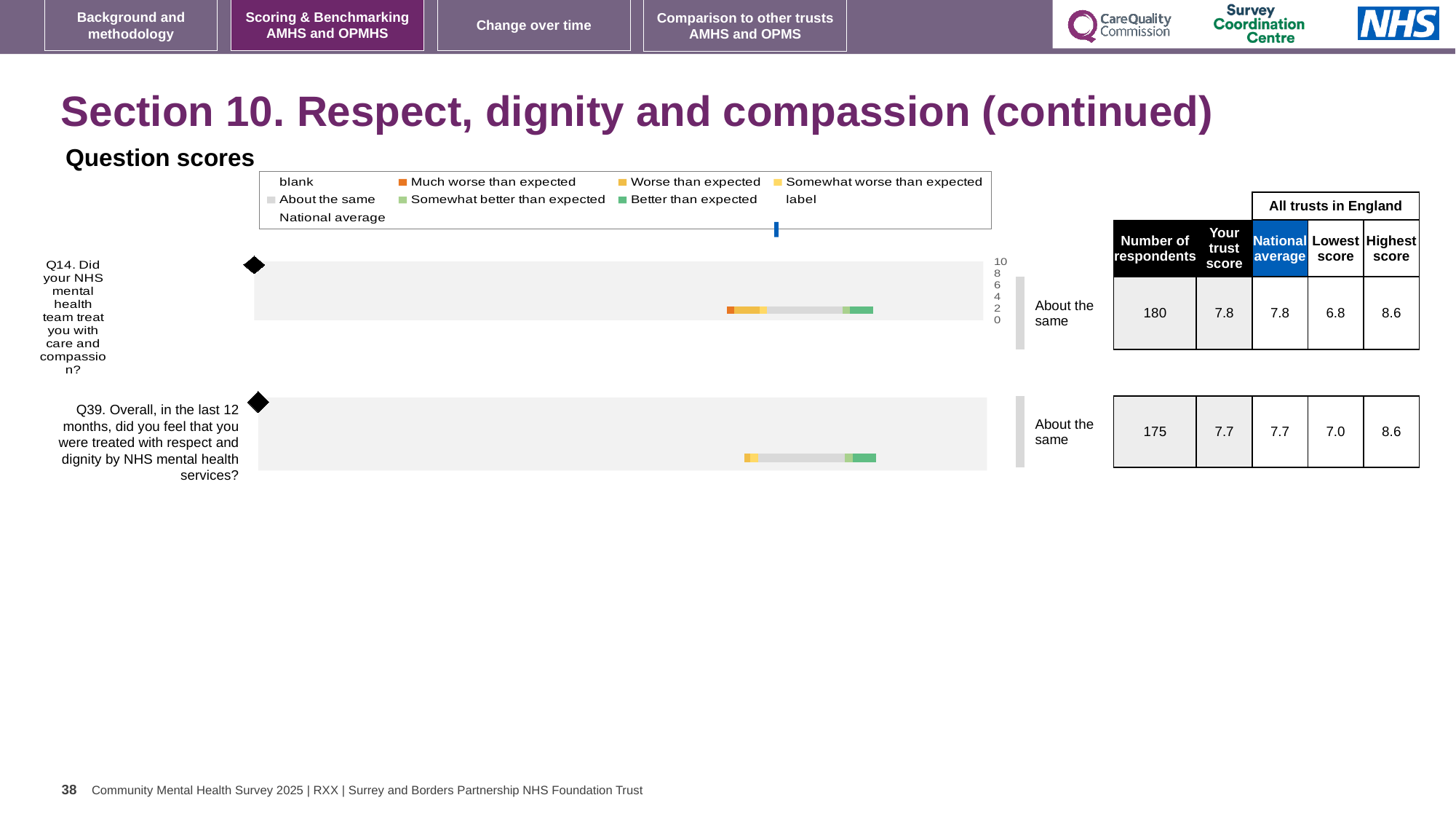
How many questions are plotted on this slide? 2 How many respondents are listed for Q39 (treated with respect and dignity)? 175 What is the difference between the highest and lowest trust scores for Q14? 1.8 What is the 'Your trust score' value for Q14 (care and compassion)? 7.8 What is the national average score for Q39? 7.7 What colour represents 'Much worse than expected' in the legend? Orange What benchmark category is shown next to the Q14 chart? About the same What is the lowest score among all trusts in England for Q14? 6.8 What is the difference between the highest and lowest trust scores for Q39? 1.6 Which question has the higher 'Your trust score', Q14 or Q39? Q14 Which question had more respondents, Q14 or Q39? Q14 What is the highest score among all trusts in England for Q39? 8.6